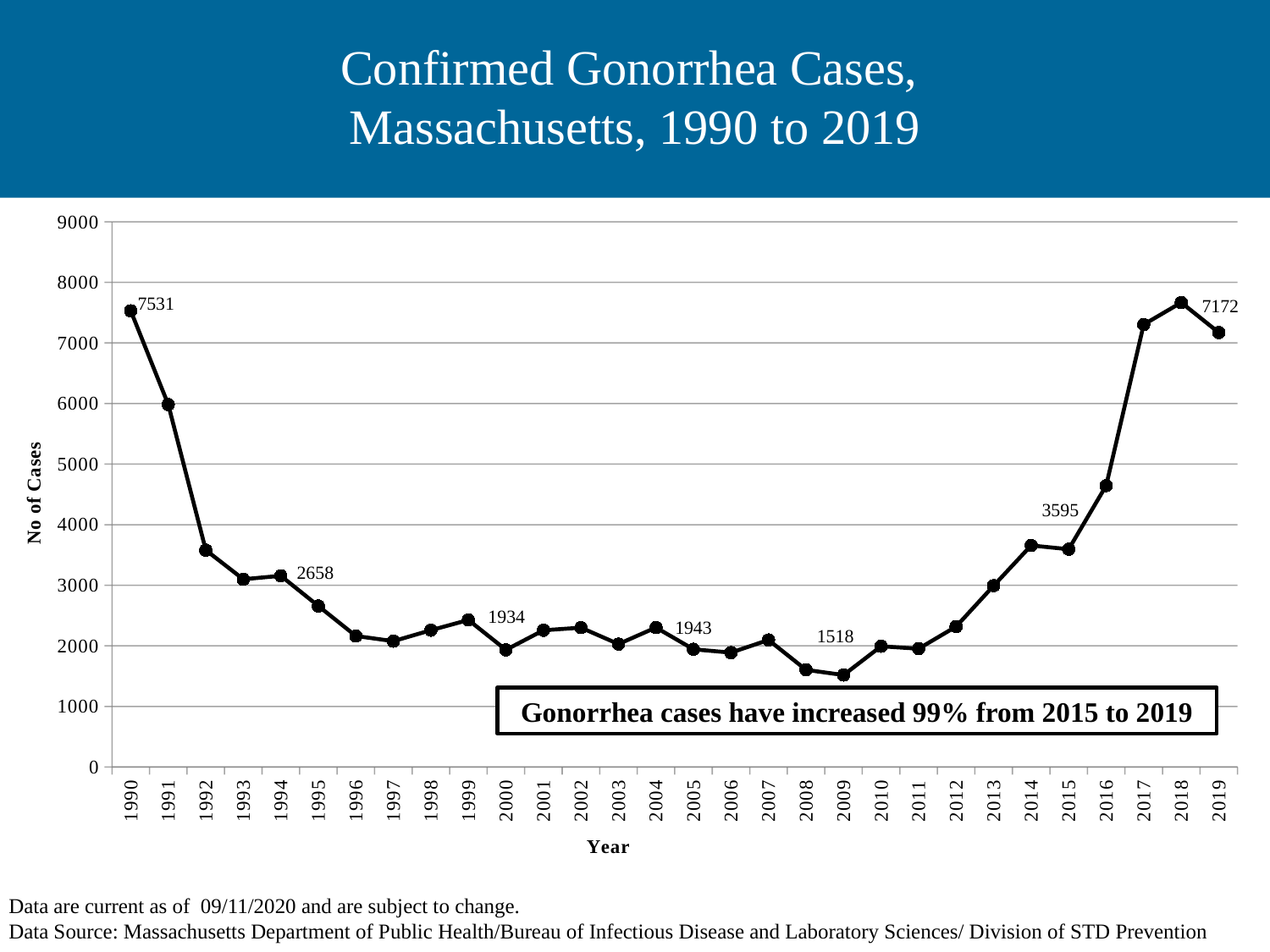
What is the difference between the number of cases in 2019 and in 2015? 3577 What value is labeled for the year 2009? 1518 What is the number of cases shown for 2019? 7172 Which year had more cases, 1990 or 2019? 1990 Is the value for 2012 greater or less than 3000? less How many confirmed gonorrhea cases were reported in Massachusetts in 1990? 7531 Is the value for 1991 greater or less than 5000? greater What type of chart is shown on the slide? line chart How many years are plotted on the x axis? 30 Do the values rise or fall from 2009 to 2018? rise How many cases are shown for 2015? 3595 Which year has the lowest number of cases on the chart? 2009